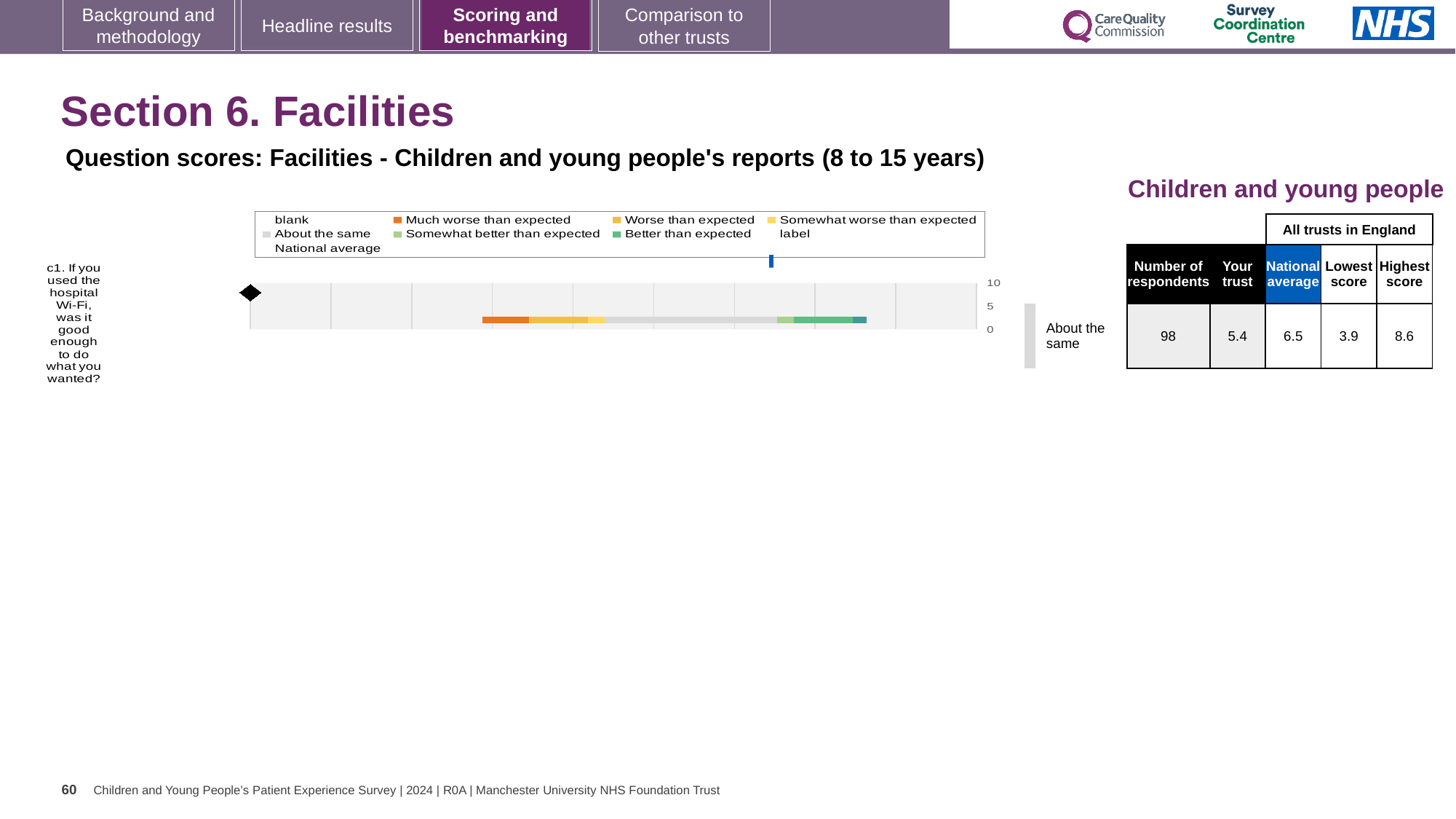
How many questions (categories) are plotted in the benchmarking chart? 1 What is the 'Your trust' score for question c1 about hospital Wi-Fi? 5.4 What kind of chart is used to show the c1 Wi-Fi question score? bar chart How many respondents answered question c1 about hospital Wi-Fi? 98 What is the lowest score among all trusts in England for question c1? 3.9 What is the highest score among all trusts in England for question c1? 8.6 What is the difference between the national average (6.5) and the trust's score (5.4) for question c1? 1.1 Which is larger for question c1: the trust's score or the national average? national average What is the national average score for question c1 about hospital Wi-Fi? 6.5 What is the maximum value shown on the chart's score axis? 10 What is the difference between the highest score (8.6) and the lowest score (3.9) for question c1? 4.7 What benchmark category is the trust's c1 score placed in? About the same